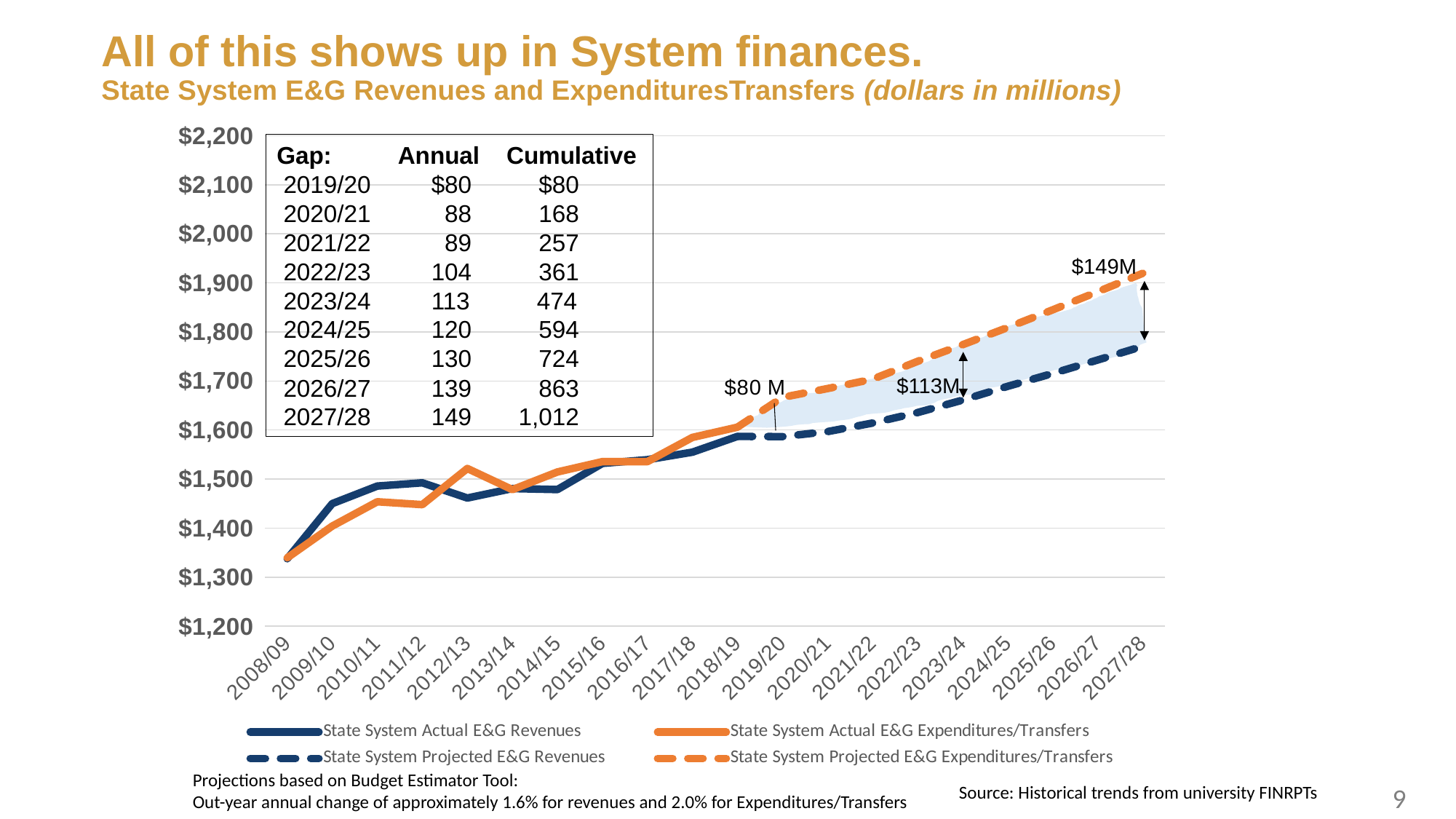
What gap is labelled on the chart for 2023/24? $113M Which fiscal year in the table has the largest annual gap? 2027/28 What kind of chart is shown on the slide? line chart Do the State System Projected E&G Expenditures/Transfers rise or fall from 2019/20 to 2027/28? rise Is the value of State System Projected E&G Revenues for 2027/28 greater or less than $1,800? less What gap is labelled on the chart for 2019/20? $80 M How many fiscal years are shown along the x axis of the chart? 20 What gap between projected expenditures/transfers and projected revenues is labelled on the chart for 2027/28? $149M According to the table on the chart, what is the cumulative gap for 2027/28? 1,012 By how much does the labelled gap for 2027/28 ($149M) exceed the labelled gap for 2023/24 ($113M)? $36M In 2009/10, which is larger: State System Actual E&G Revenues or State System Actual E&G Expenditures/Transfers? State System Actual E&G Revenues How many series does the chart legend list? 4